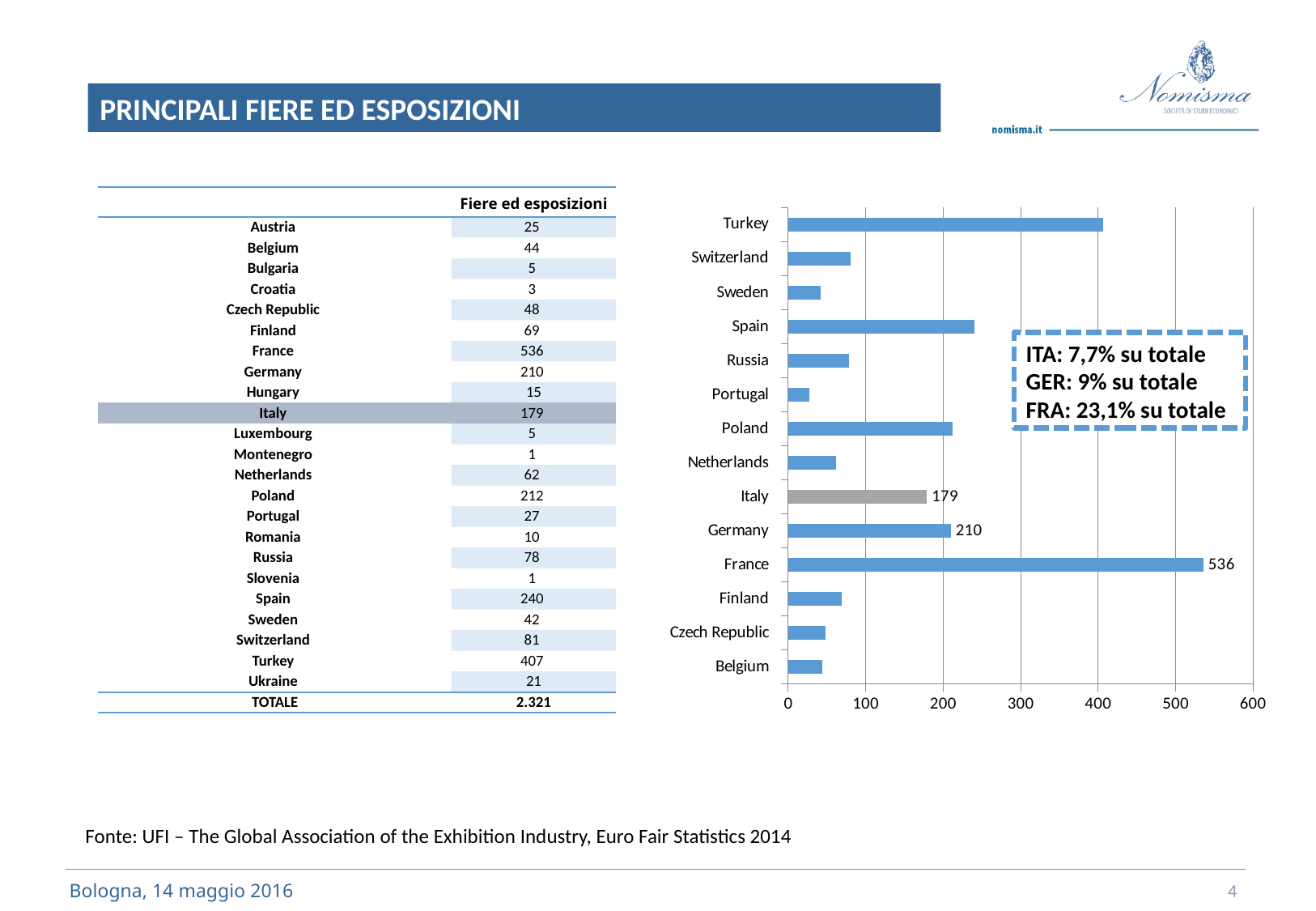
How many countries are shown in the bar chart? 14 What is the difference between the values for Germany and Italy in the bar chart? 31 What is the value shown for France in the bar chart? 536 Which country has the highest value in the bar chart? France What is the difference between the values for France and Germany in the bar chart? 326 What is the value shown for Italy in the bar chart? 179 What is the value shown for Germany in the bar chart? 210 In the bar chart, is the value for Turkey greater or less than 300? greater Which country has the lowest value in the bar chart? Portugal In the bar chart, which is larger, the value for Turkey or the value for Spain? Turkey What kind of chart is shown on the slide? bar chart In the bar chart, is the value for Switzerland greater or less than 100? less